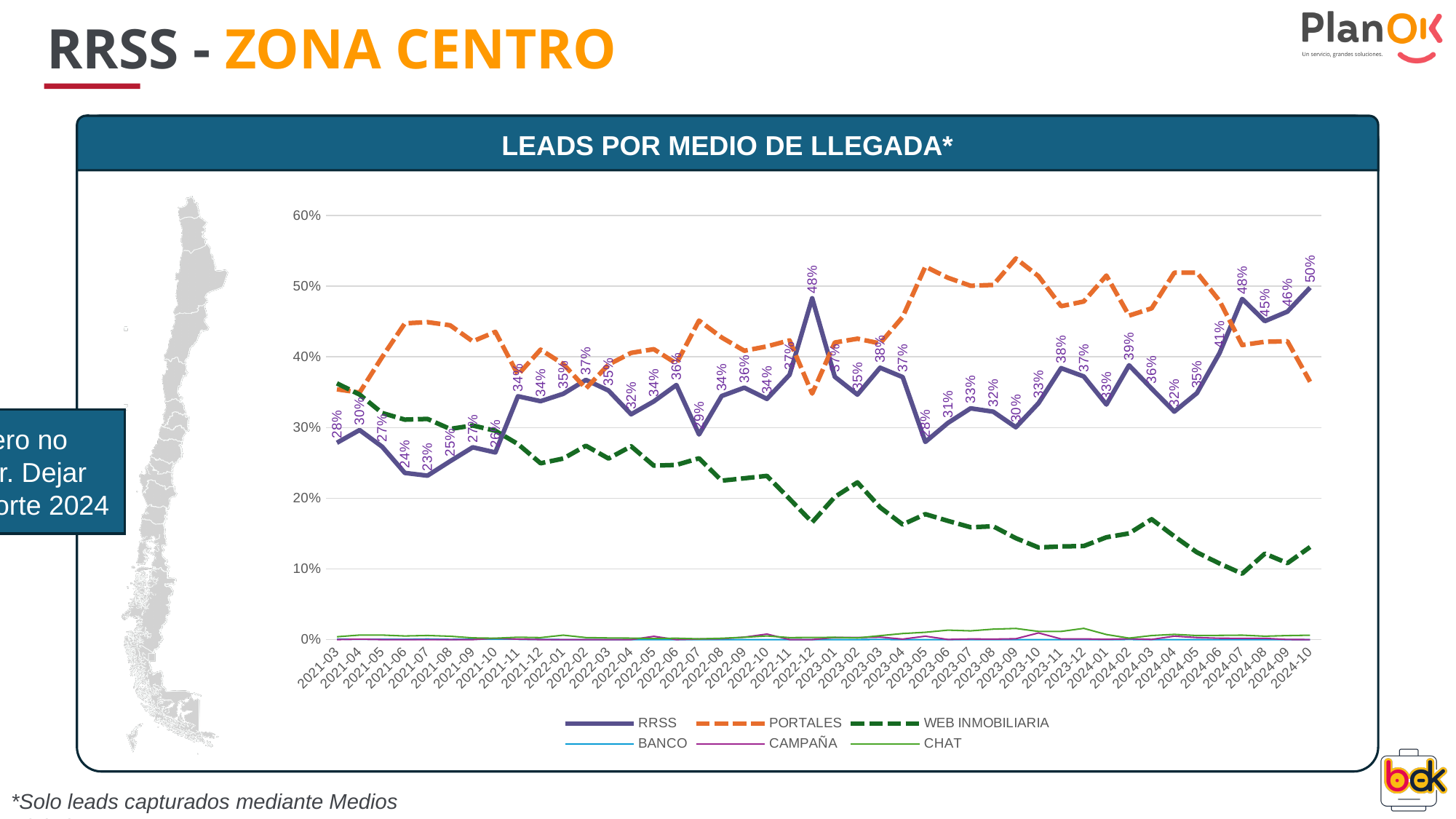
What is the RRSS value for 2022-12? 48% How many months are shown on the x axis of the chart? 44 What is the difference between the RRSS value in 2024-10 and in 2021-03? 22 percentage points Is the PORTALES value for 2023-09 greater or less than 50%? greater In which month does the RRSS series reach its lowest value? 2021-07 In which month does the RRSS series reach its highest value? 2024-10 What is the RRSS value for 2021-07? 23% What is the RRSS value for 2024-10? 50% Is the WEB INMOBILIARIA value for 2024-10 greater or less than 20%? less Which series has the larger value in 2024-10, RRSS or PORTALES? RRSS How many series does the legend of the chart list? 6 What type of chart is shown under the title 'LEADS POR MEDIO DE LLEGADA*'? Line chart